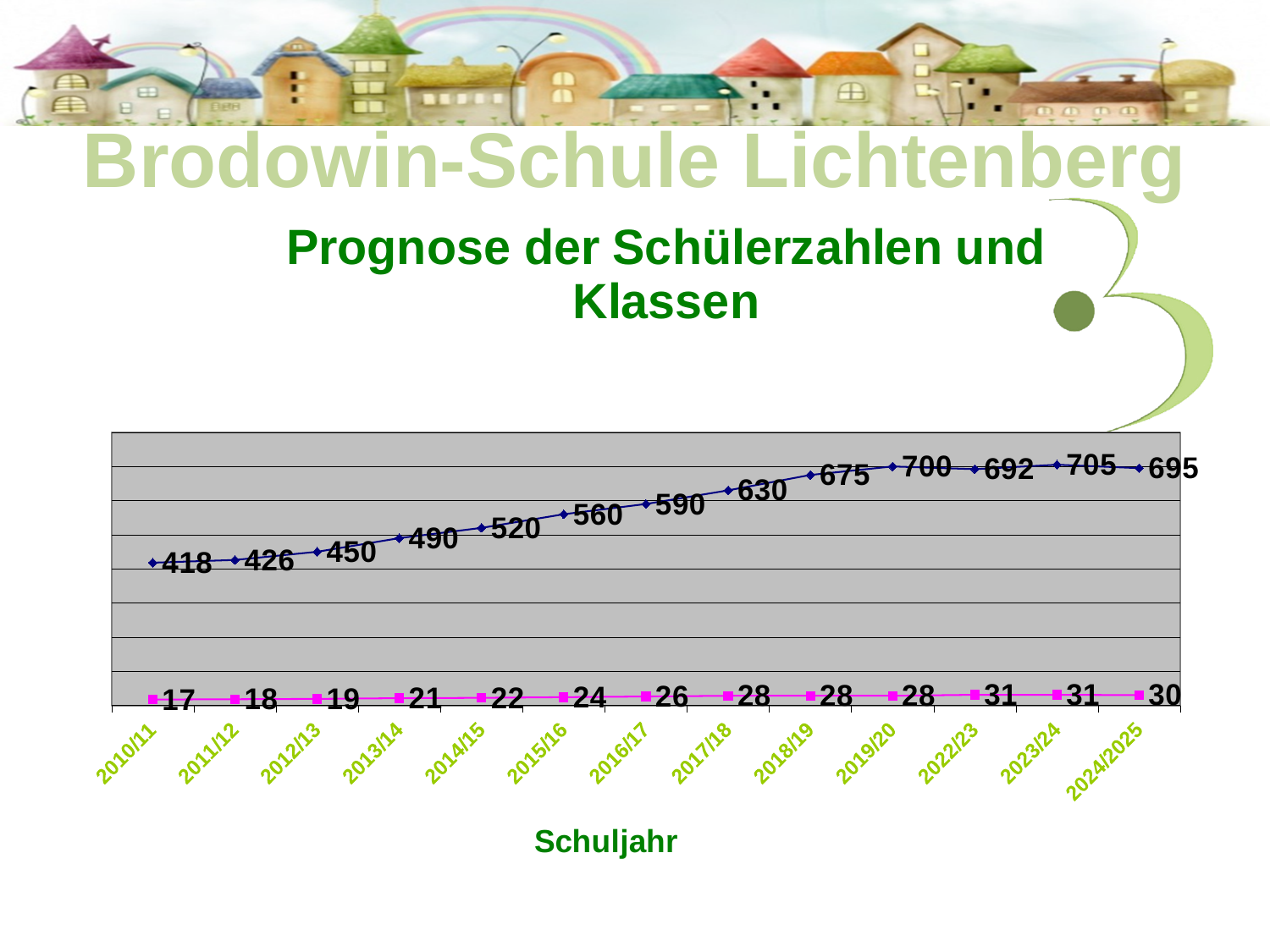
What is the value of the upper line for 2018/19? 675 What type of chart is shown on the slide? line chart What is the value of the lower line for 2024/2025? 30 What is the x-axis title of the chart? Schuljahr What is the value of the lower line for 2016/17? 26 Which is larger, the upper line's value for 2022/23 or for 2024/2025? 2024/2025 Does the upper line generally rise or fall from 2010/11 to 2019/20? rise In which school year does the upper line reach its highest value? 2023/24 In which school year does the lower line have its lowest value? 2010/11 How many school years are shown on the x axis? 13 What is the value of the upper line for 2010/11? 418 What is the difference between the upper line's values for 2019/20 and 2010/11? 282